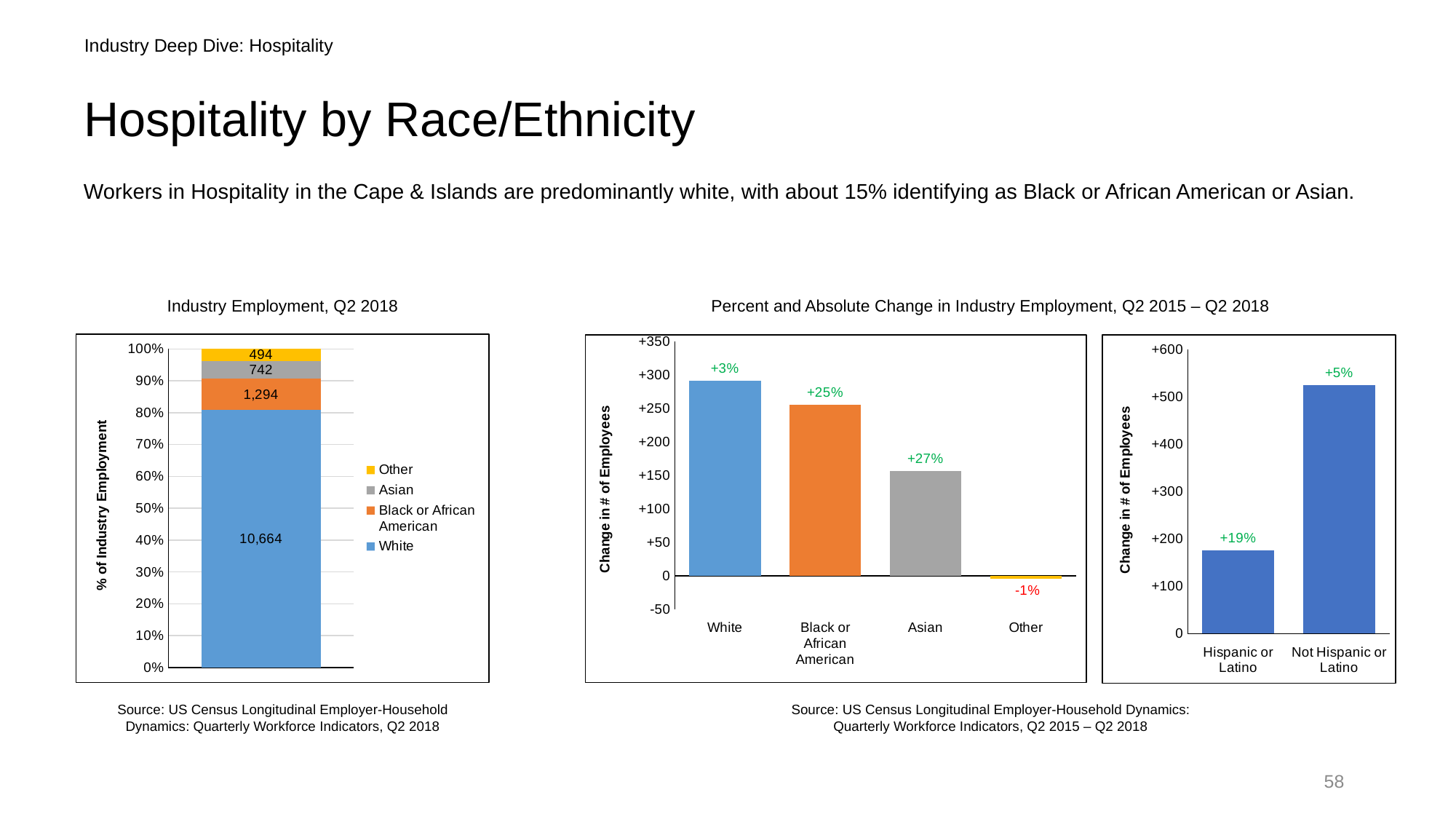
How many series does the legend of the 'Industry Employment, Q2 2018' chart list? 4 What kind of chart is the 'Industry Employment, Q2 2018' chart? Stacked bar chart In the rightmost chart (change in employment by ethnicity), what percent change is labelled for Hispanic or Latino? +19% In the 'Industry Employment, Q2 2018' chart, what is the difference between the Black or African American segment and the Asian segment? 552 In the 'Industry Employment, Q2 2018' chart, what is the total of all four segments in the stacked bar? 13,194 In the middle chart (change in employment by race), what percent change is labelled for Asian? +27% In the middle chart (change in employment by race), is the absolute change for Asian greater or less than +200? less In the middle chart (change in employment by race), which category has the largest absolute change in number of employees? White In the 'Industry Employment, Q2 2018' chart, how many employees are shown for the White segment? 10,664 In the rightmost chart (change in employment by ethnicity), is the absolute change for Not Hispanic or Latino greater or less than +500? greater In the middle chart (change in employment by race), what percent change is labelled for Other? -1% In the 'Industry Employment, Q2 2018' chart, what value is labelled on the Asian segment? 742